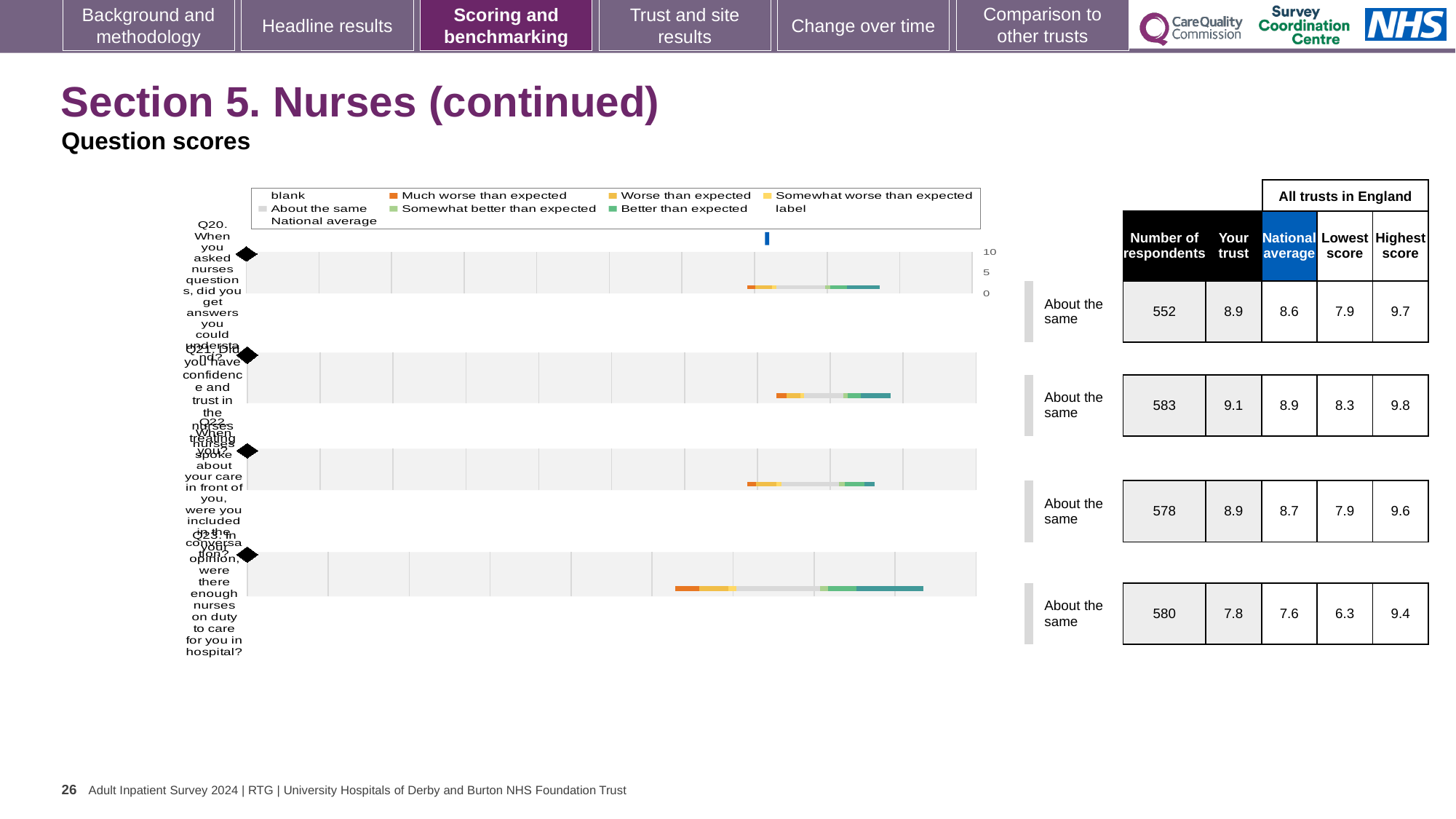
What is the difference between the 'Your trust' score and the national average for Q21? 0.2 What benchmark category is shown for all four questions? About the same For Q20, which is larger: the 'Your trust' score or the national average? Your trust What is the 'Your trust' score for Q21 (confidence and trust in the nurses)? 9.1 What is the national average score for Q23 (enough nurses on duty)? 7.6 Which question has the highest 'Your trust' score? Q21 What kind of chart is shown on the slide? bar chart How many questions (categories) are plotted in the chart? 4 What is the difference between the highest score and the lowest score for Q23? 3.1 Which question has the lowest 'Your trust' score? Q23 How many respondents answered Q22? 578 Is the 'Your trust' marker for Q23 greater or less than 5 on the axis? greater